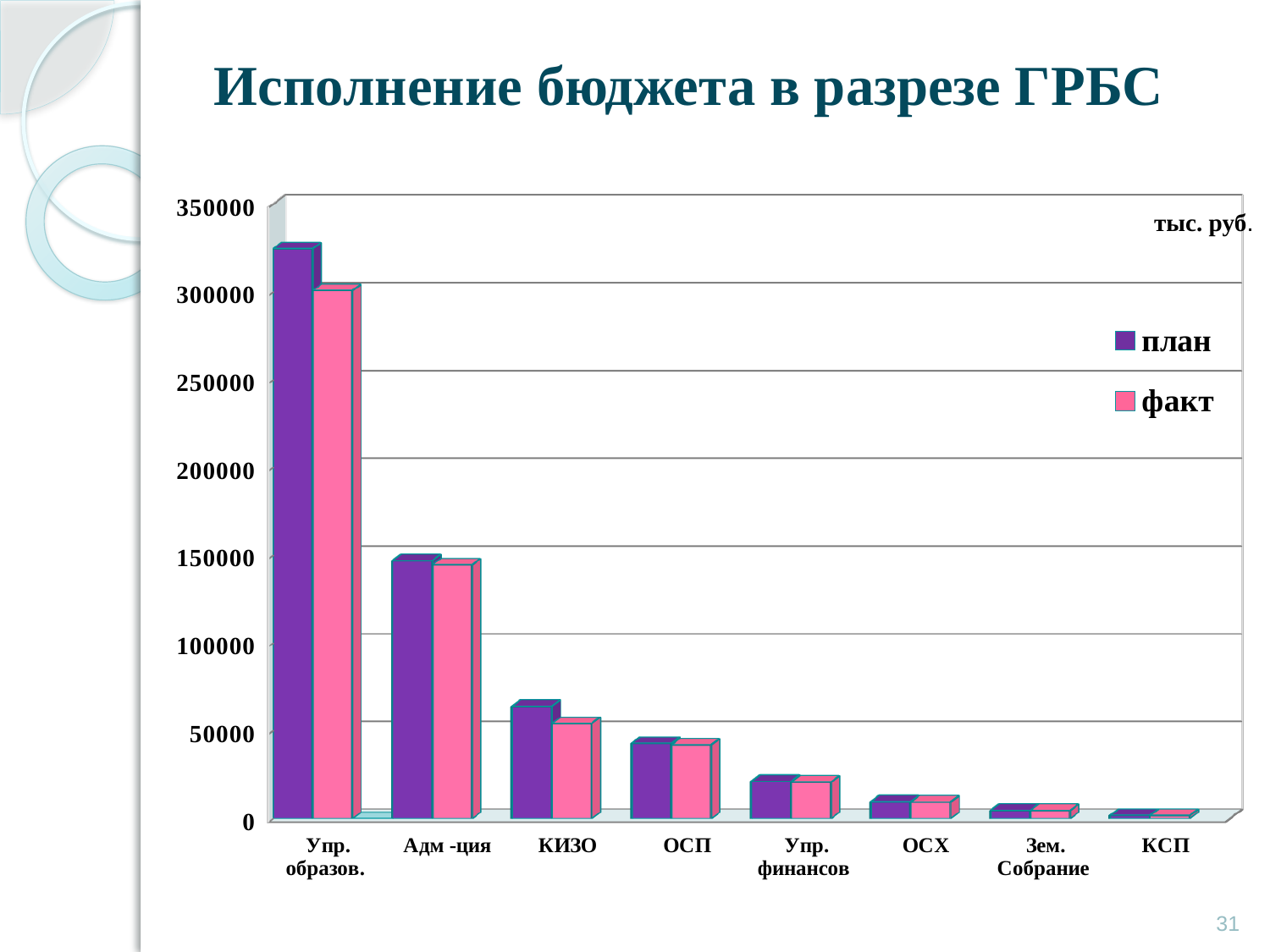
What kind of chart is shown on the slide? bar chart Is the план value for Упр. образов. greater or less than 300000? greater What is the title of the chart on the slide? Исполнение бюджета в разрезе ГРБС For Упр. образов., which is larger: план or факт? план How many categories are shown on the x axis of the chart? 8 Do the план values rise or fall moving from left to right along the x axis? fall Is the план value for КИЗО greater or less than 50000? greater Which category has the lowest факт value? КСП Is the факт value for Упр. финансов greater or less than 50000? less How many series does the legend list? 2 Which category has the highest план value? Упр. образов.